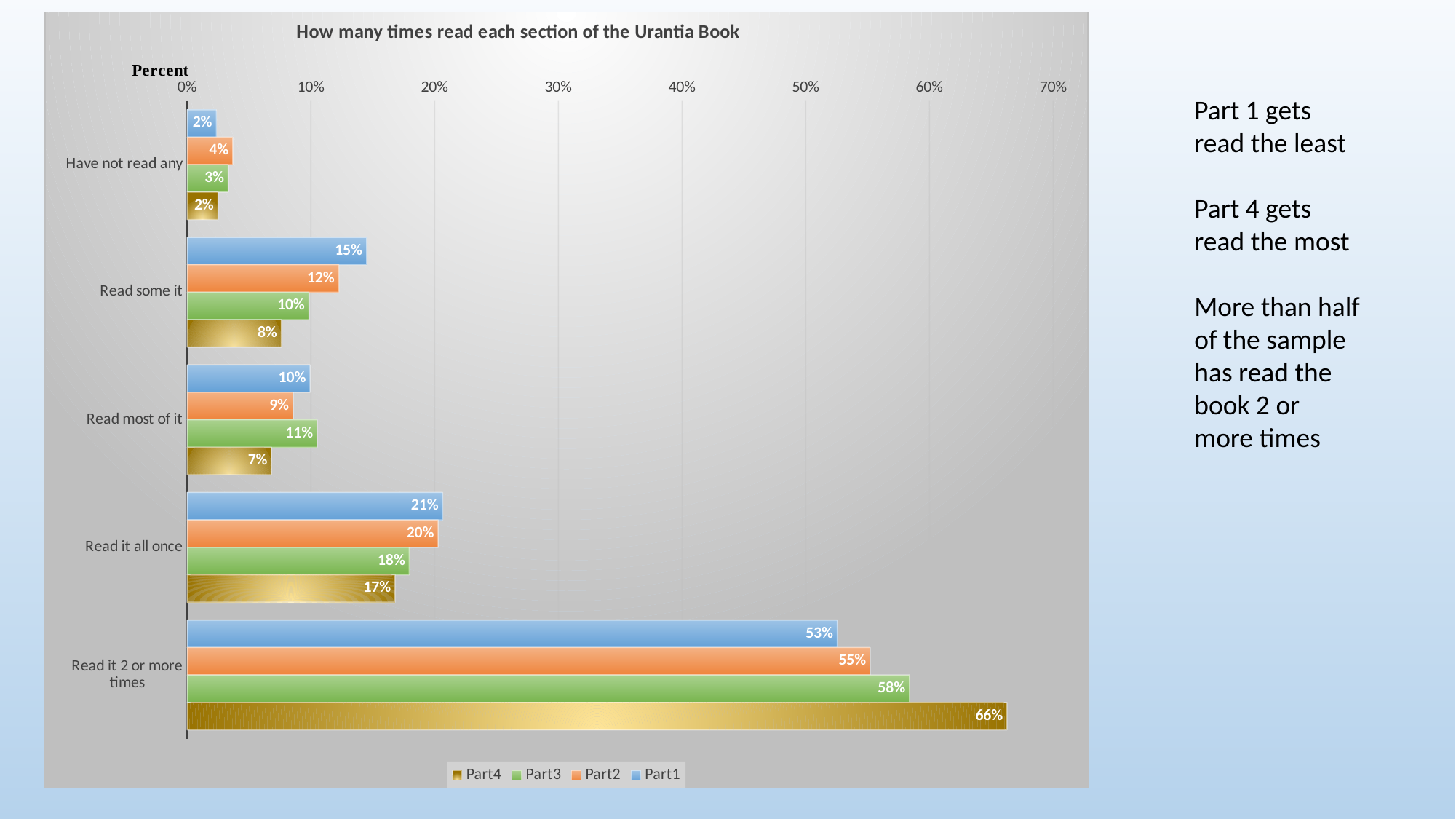
Which series has the lowest value in the 'Read most of it' category? Part4 How many categories are shown on the y axis? 5 Which is larger in the 'Read most of it' category: Part3 or Part2? Part3 What kind of chart is shown on the slide? Bar chart What is the difference between Part4 and Part1 in the 'Read it 2 or more times' category? 13% How many series does the legend list? 4 What is the value for Part4 in the 'Read it 2 or more times' category? 66% Which series has the highest value in the 'Read it 2 or more times' category? Part4 What is the title of the chart? How many times read each section of the Urantia Book What is the value for Part2 in the 'Have not read any' category? 4% What is the value for Part1 in the 'Read some it' category? 15% What is the value for Part3 in the 'Read it all once' category? 18%